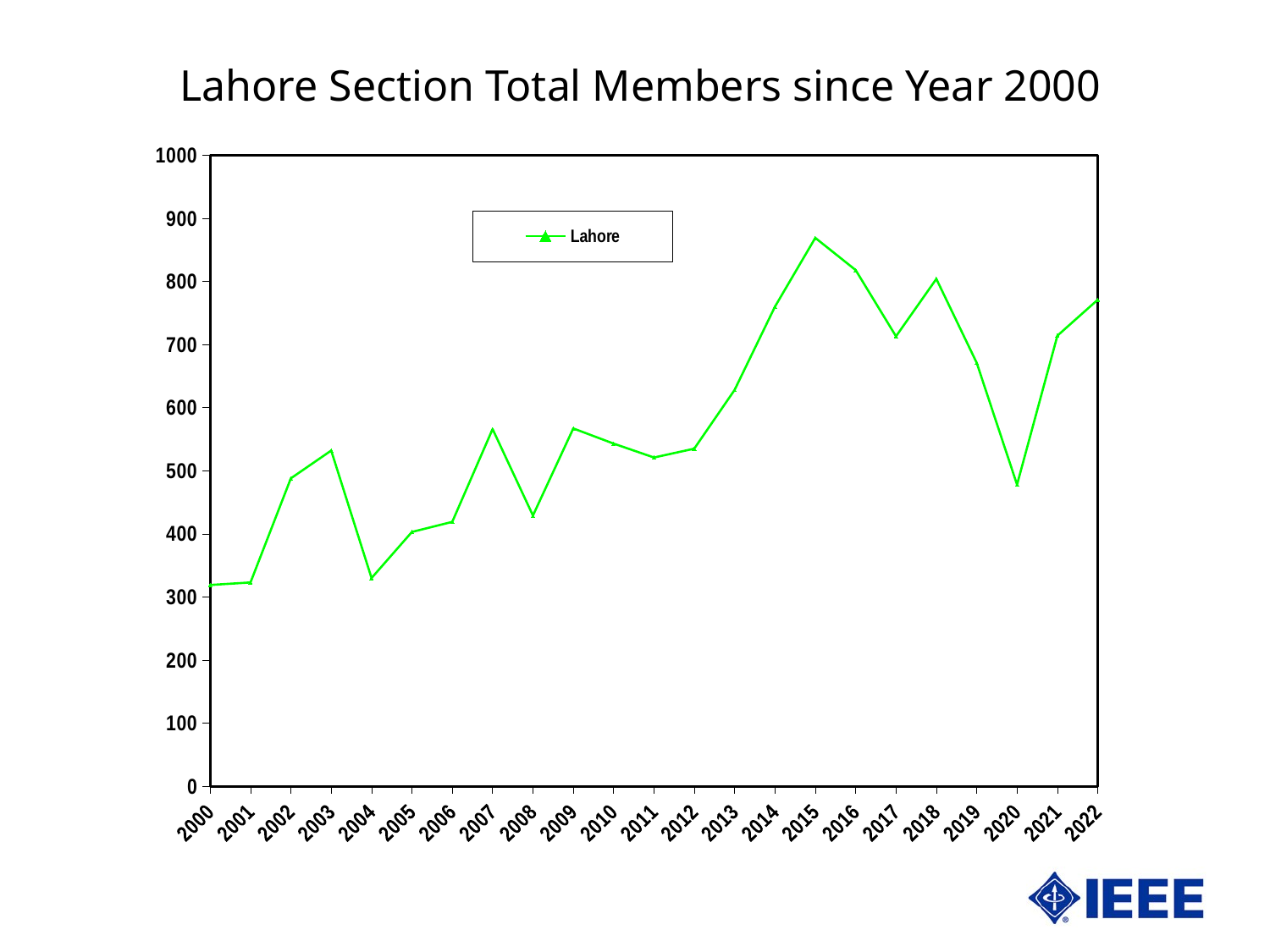
Is the value for 2015 greater or less than 800? greater What is the title of the chart? Lahore Section Total Members since Year 2000 How many years are plotted along the x axis? 23 What kind of chart is shown on the slide? line chart Is the value for 2022 greater or less than 700? greater Which year has the larger value, 2015 or 2020? 2015 Do the values rise or fall from 2012 to 2015? rise Is the value for 2000 greater or less than 400? less Which year has the larger value, 2004 or 2007? 2007 How many series does the legend list? 1 Which year has the highest number of members? 2015